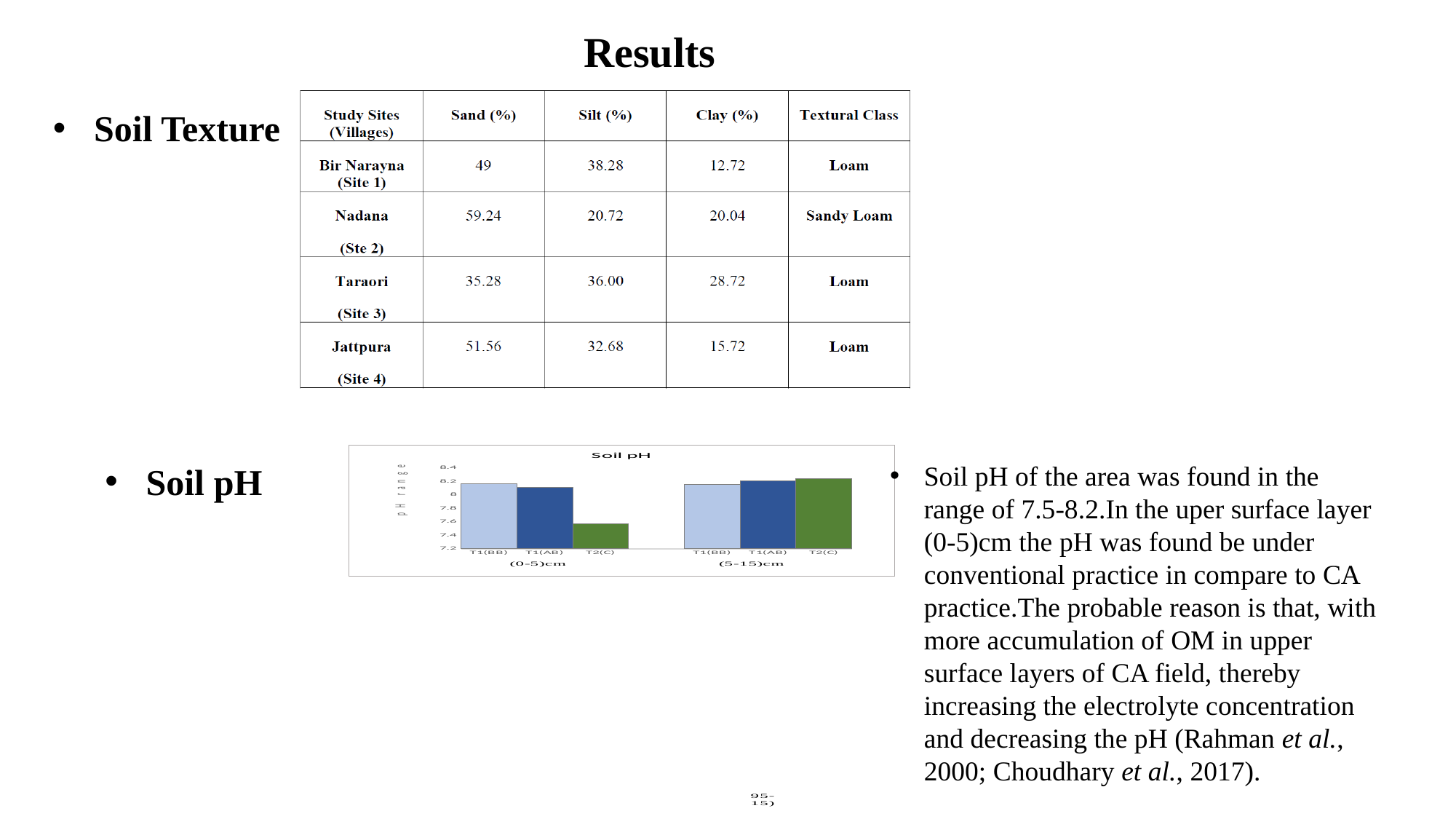
In the Soil pH chart, do the values rise or fall from T1(BB) to T2(C) within the (0-5)cm group? fall In the Soil pH chart, is the value for T1(BB) in the (0-5)cm group greater or less than 8? greater In the Soil pH chart, which is larger in the (0-5)cm group: T1(BB) or T2(C)? T1(BB) What kind of chart is the Soil pH chart? bar chart In the Soil pH chart, is the T2(C) value larger in the (0-5)cm group or the (5-15)cm group? (5-15)cm How many depth groups are shown on the x axis of the Soil pH chart? 2 What is the label on the vertical axis of the Soil pH chart? pH range In the Soil pH chart, is the value for T2(C) in the (5-15)cm group greater or less than 8? greater How many bars are plotted in the Soil pH chart? 6 In the Soil pH chart, is the value for T2(C) in the (0-5)cm group greater or less than 7.8? less What is the title of the chart on the slide? Soil pH In the Soil pH chart, which bar is the lowest? T2(C) in (0-5)cm